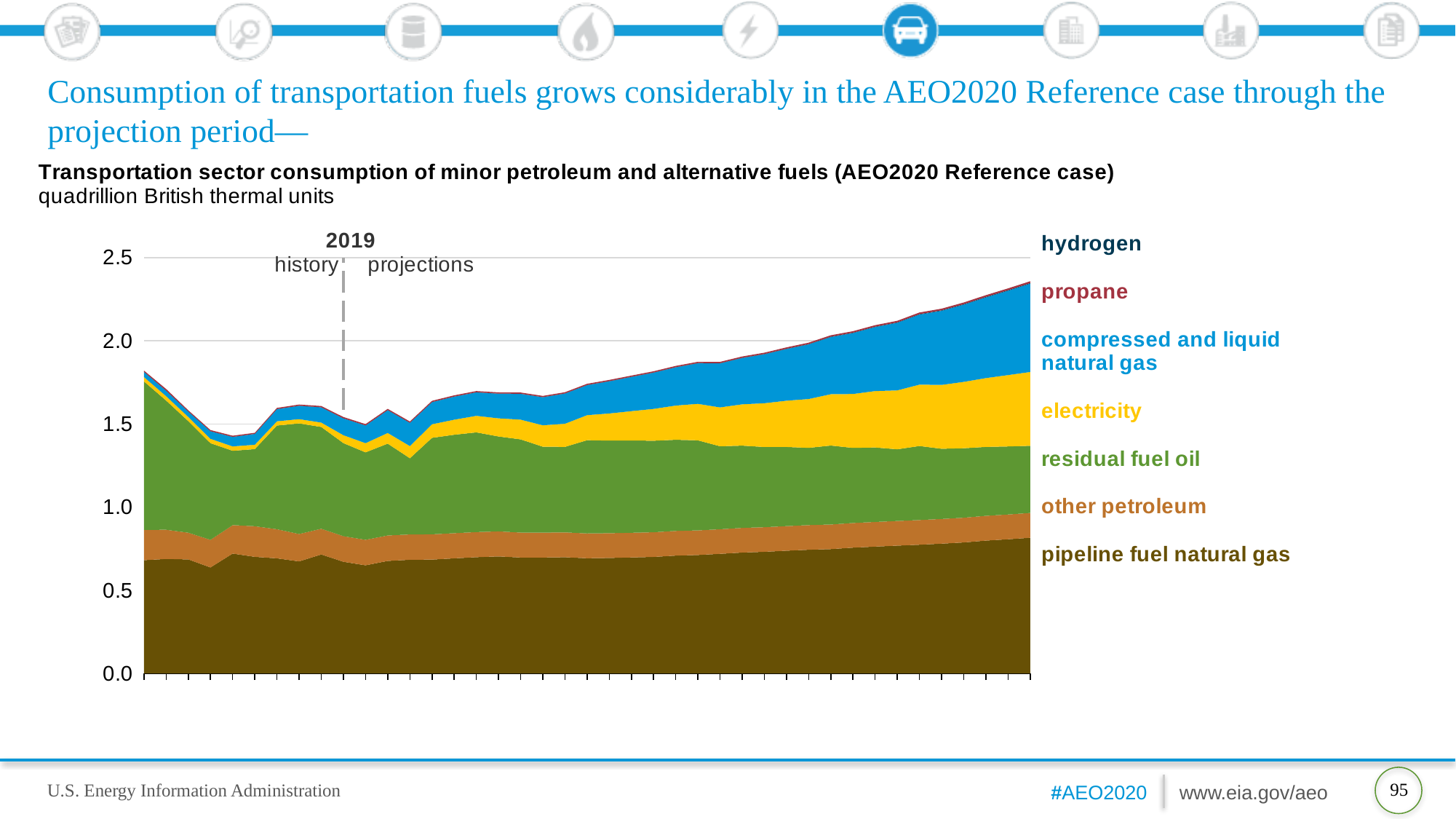
Is the total consumption in 2019 greater or less than 2.0? less Which series is the largest at the end of the projection period? pipeline fuel natural gas Is the total consumption at the start of the history period greater or less than 2.0? less Does the compressed and liquid natural gas area grow or shrink over the projection period? grow What kind of chart is shown on the slide? stacked area chart What is the title of the chart? Transportation sector consumption of minor petroleum and alternative fuels (AEO2020 Reference case) Is the value for pipeline fuel natural gas at the end of the projection period greater or less than 0.5? greater How many fuel series does the legend list? 7 Does total consumption rise or fall over the projection period? rise What unit is the y axis measured in? quadrillion British thermal units Which series forms the bottom layer of the stacked area chart? pipeline fuel natural gas